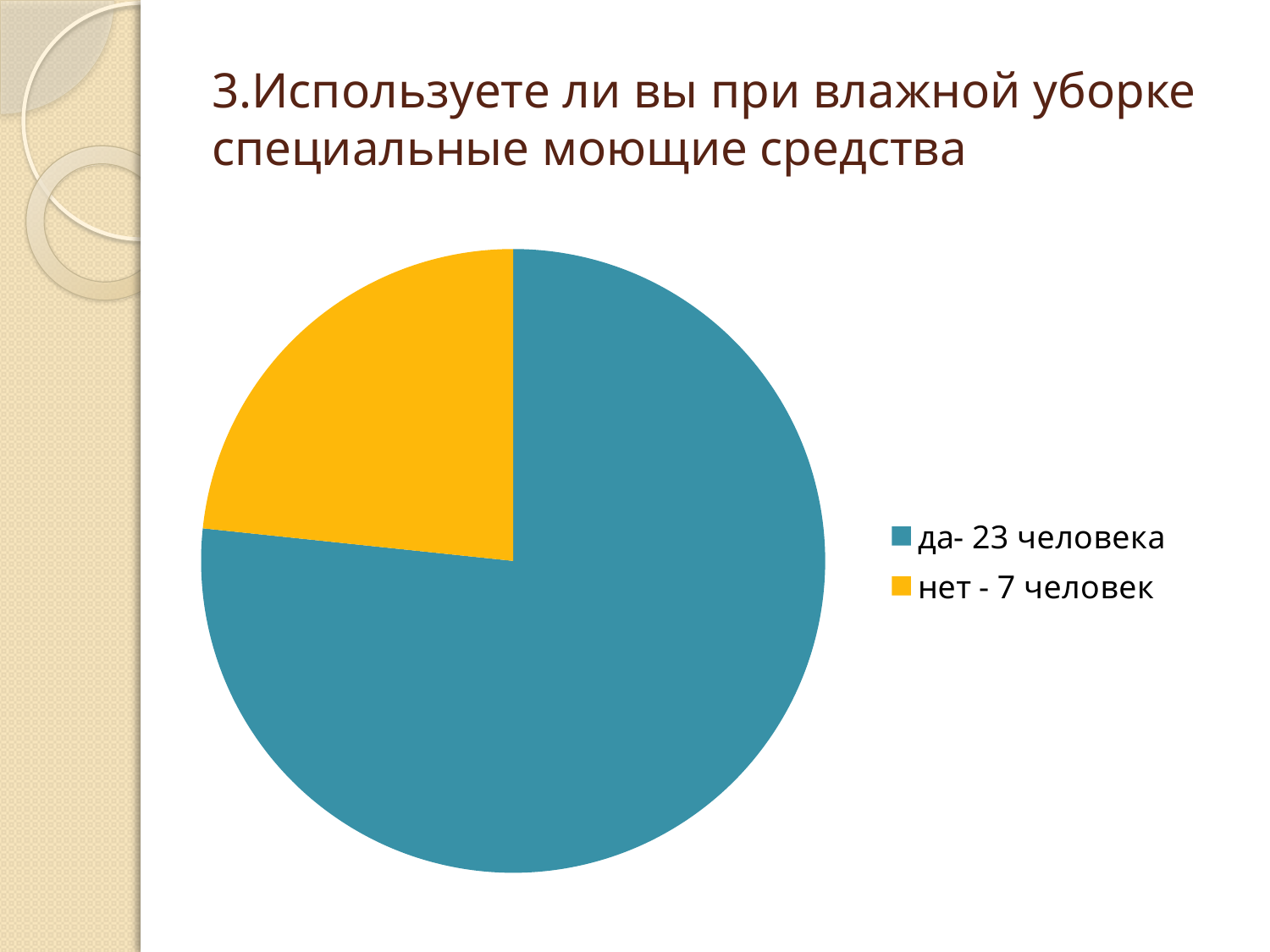
What kind of chart is shown on the slide? pie chart How many slices does the pie chart have? 2 What is the total number of people represented in the pie chart? 30 Which answer has the smallest slice of the pie? нет How many people answered "да" according to the legend? 23 человека How many more people answered "да" than "нет"? 16 What colour is the slice for "да"? blue How many entries does the legend list? 2 What colour is the slice for "нет"? yellow How many people answered "нет" according to the legend? 7 человек Which is larger, the number of people who answered "да" or the number who answered "нет"? да Which answer has the largest slice of the pie? да